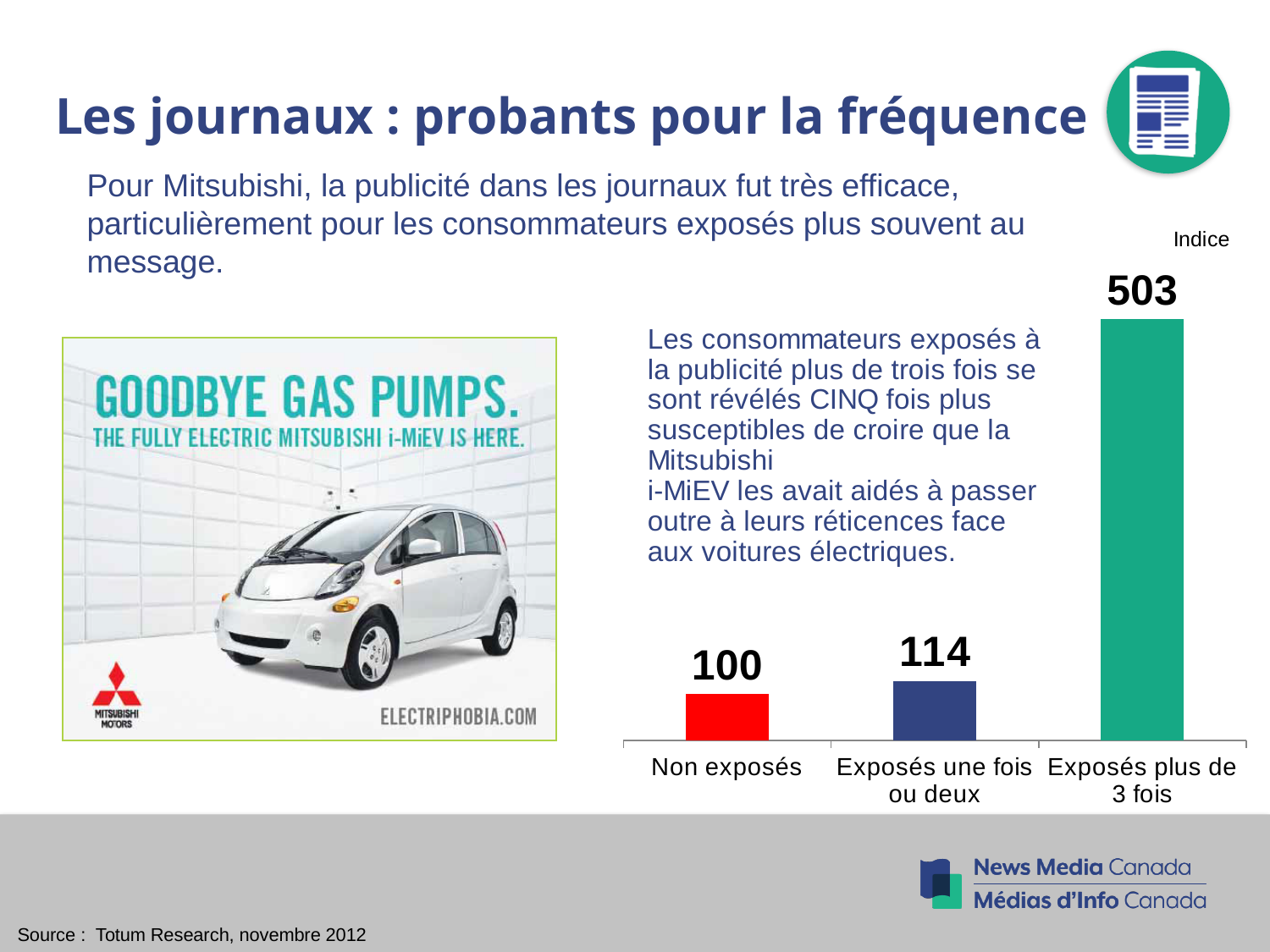
Which category has the highest index value? Exposés plus de 3 fois What colour is the bar for "Exposés plus de 3 fois"? Green What is the index value for "Exposés plus de 3 fois"? 503 How many categories are shown in the chart? 3 Which category has the lowest index value? Non exposés What kind of chart is shown on the slide? Bar chart Which is larger: the index for "Exposés une fois ou deux" or for "Non exposés"? Exposés une fois ou deux What is the difference between the index values for "Exposés une fois ou deux" and "Non exposés"? 14 What is the index value for "Non exposés"? 100 What is the index value for "Exposés une fois ou deux"? 114 Do the index values rise or fall from left to right across the categories? Rise What is the difference between the index values for "Exposés plus de 3 fois" and "Non exposés"? 403